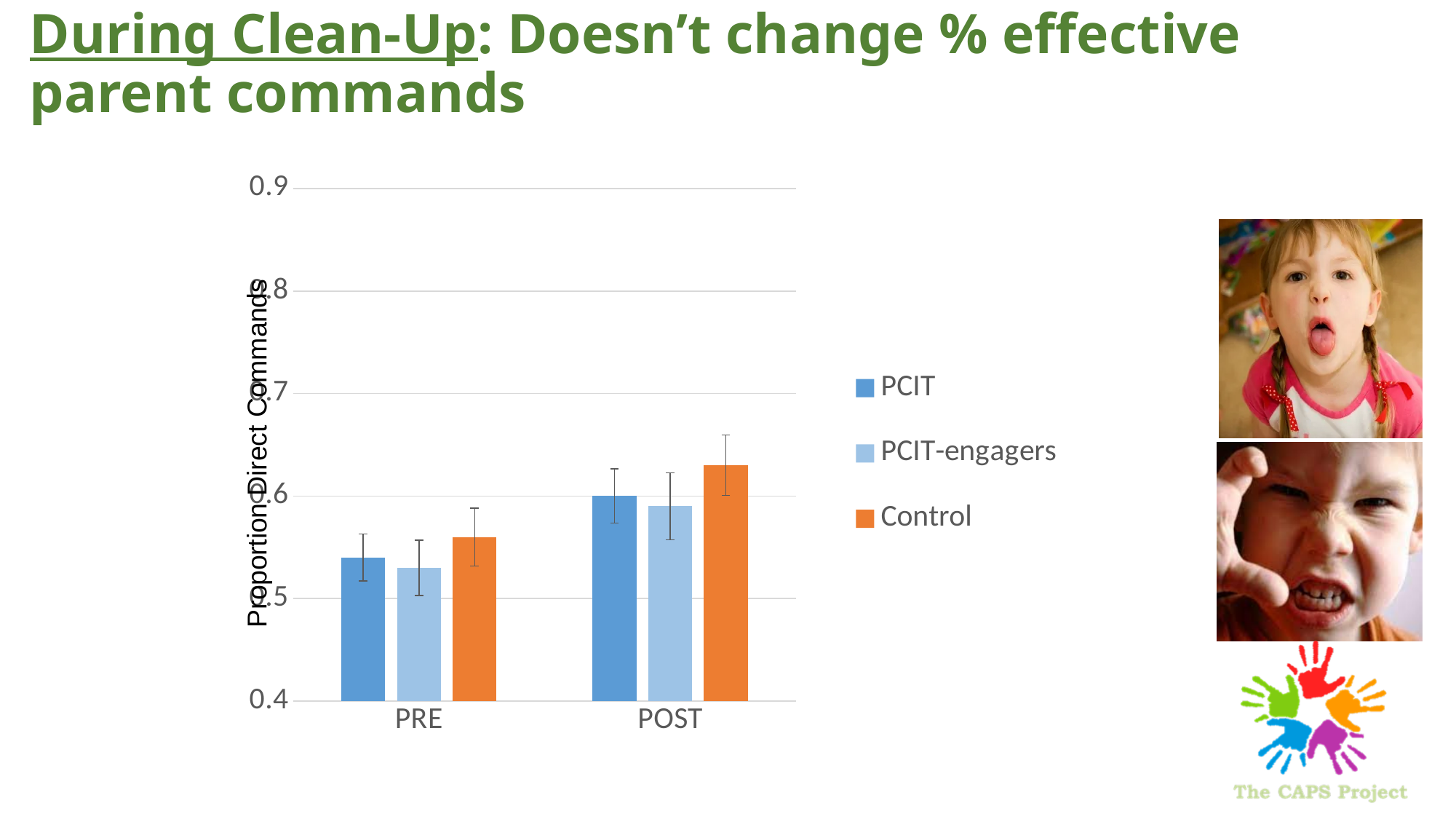
Is the value for PCIT at PRE greater or less than 0.5? greater Is the value for Control at PRE greater or less than 0.6? less How many categories are shown on the x axis? 2 Is the value for Control at POST greater or less than 0.6? greater Do the values for each series rise or fall from PRE to POST? rise Which series are listed in the legend? PCIT, PCIT-engagers, Control At POST, which is larger: the Control bar or the PCIT-engagers bar? Control At PRE, which series has the highest value? Control What kind of chart is shown on the slide? bar chart How many series does the legend list? 3 What is the label of the vertical axis? Proportion Direct Commands